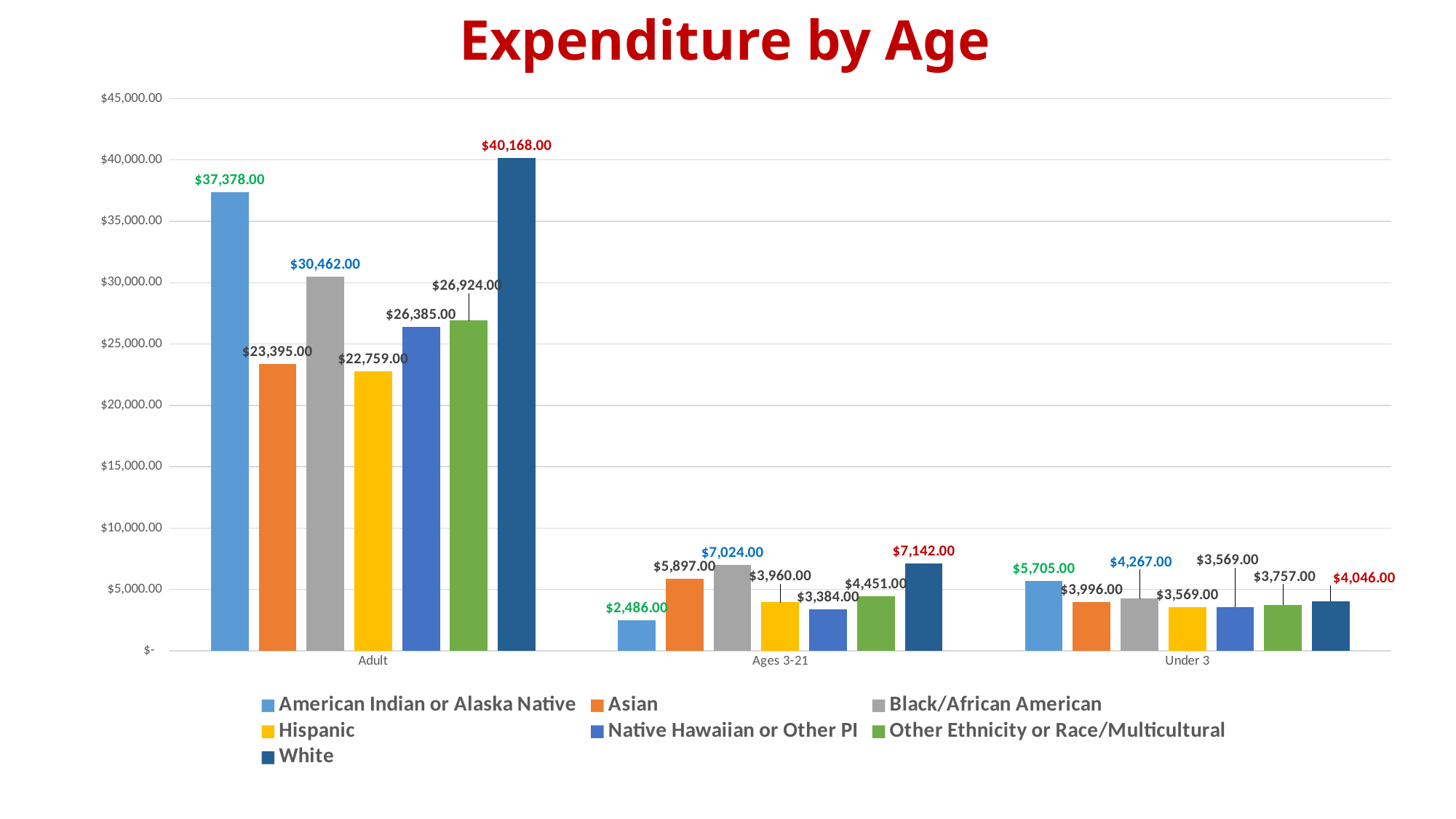
What type of chart is shown on the slide? Bar chart What is the expenditure for Hispanic in the Ages 3-21 category? $3,960.00 What is the expenditure for American Indian or Alaska Native in the Under 3 category? $5,705.00 Is the expenditure for Hispanic in the Adult category greater or less than $25,000.00? less How many age categories are shown on the x axis? 3 In the Adult category, which is larger: the expenditure for Asian or for Black/African American? Black/African American How many series does the legend list? 7 Which group has the highest expenditure in the Adult category? White What is the expenditure for White in the Adult category? $40,168.00 What is the difference between the White and American Indian or Alaska Native expenditures in the Adult category? $2,790.00 What is the title of the chart? Expenditure by Age Which group has the lowest expenditure in the Ages 3-21 category? American Indian or Alaska Native